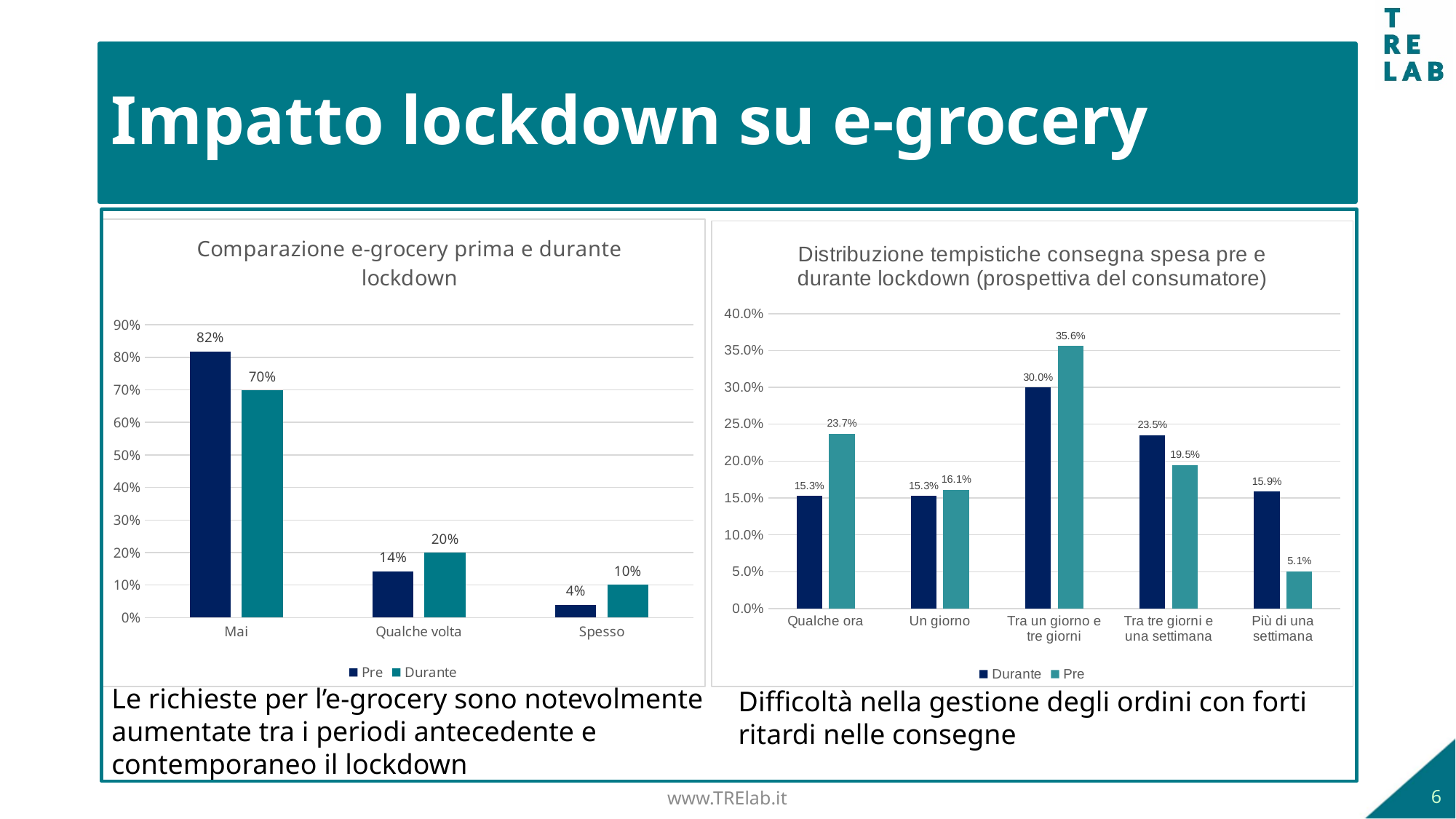
In the chart 'Comparazione e-grocery prima e durante lockdown', how many categories are shown on the x axis? 3 In the chart 'Distribuzione tempistiche consegna spesa pre e durante lockdown', what is the difference between the Durante and Pre values for 'Più di una settimana'? 10.8% In the chart 'Distribuzione tempistiche consegna spesa pre e durante lockdown', what is the Pre value for 'Tra un giorno e tre giorni'? 35.6% In the chart 'Comparazione e-grocery prima e durante lockdown', what kind of chart is it? Bar chart In the chart 'Distribuzione tempistiche consegna spesa pre e durante lockdown', how many series does the legend list? 2 In the chart 'Distribuzione tempistiche consegna spesa pre e durante lockdown', is the Pre value for 'Qualche ora' larger or the Durante value? Pre In the chart 'Comparazione e-grocery prima e durante lockdown', what is the Durante value for 'Qualche volta'? 20% In the chart 'Comparazione e-grocery prima e durante lockdown', which category has the lowest Pre value? Spesso In the chart 'Comparazione e-grocery prima e durante lockdown', what is the Pre value for 'Mai'? 82% In the chart 'Distribuzione tempistiche consegna spesa pre e durante lockdown', which category has the highest Durante value? Tra un giorno e tre giorni In the chart 'Comparazione e-grocery prima e durante lockdown', what is the difference between the Pre and Durante values for 'Mai'? 12% In the chart 'Distribuzione tempistiche consegna spesa pre e durante lockdown', what is the Durante value for 'Più di una settimana'? 15.9%